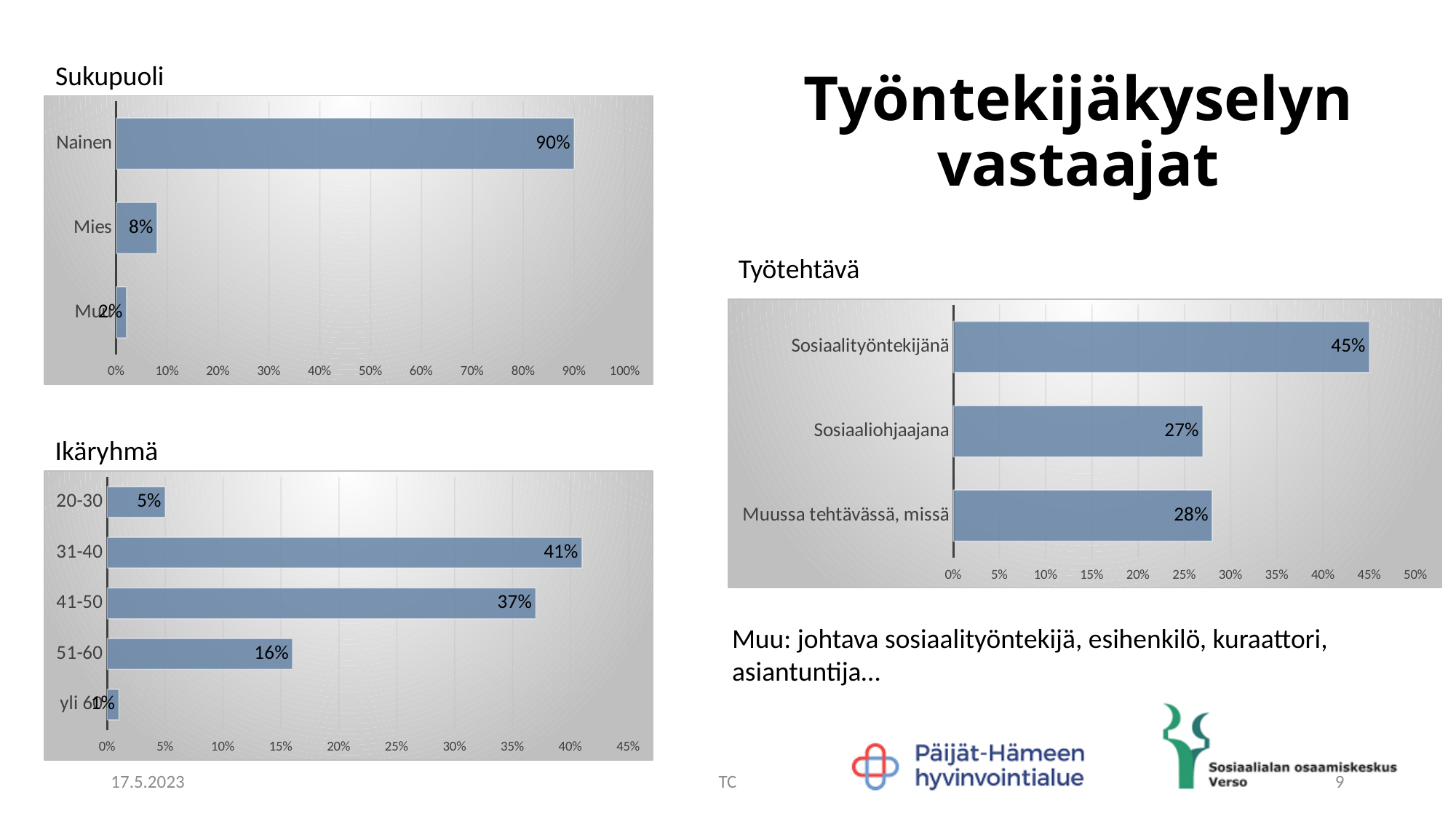
In the Ikäryhmä chart, how many age groups are shown? 5 In the Sukupuoli chart, what is the difference between the values for Nainen and Mies? 82% In the Ikäryhmä chart, which age group has the lowest value? yli 60 In the Työtehtävä chart, what is the difference between the values for Muussa tehtävässä, missä and Sosiaaliohjaajana? 1% In the Sukupuoli chart, what is the value for Mies? 8% In the Sukupuoli chart, what is the value for Nainen? 90% What kind of chart is the Työtehtävä chart? Bar chart In the Työtehtävä chart, what is the value for Sosiaalityöntekijänä? 45% In the Ikäryhmä chart, what is the value for 51-60? 16% In the Sukupuoli chart, how many categories are shown? 3 In the Ikäryhmä chart, which age group has the highest value? 31-40 In the Ikäryhmä chart, what is the difference between the values for 31-40 and 41-50? 4%